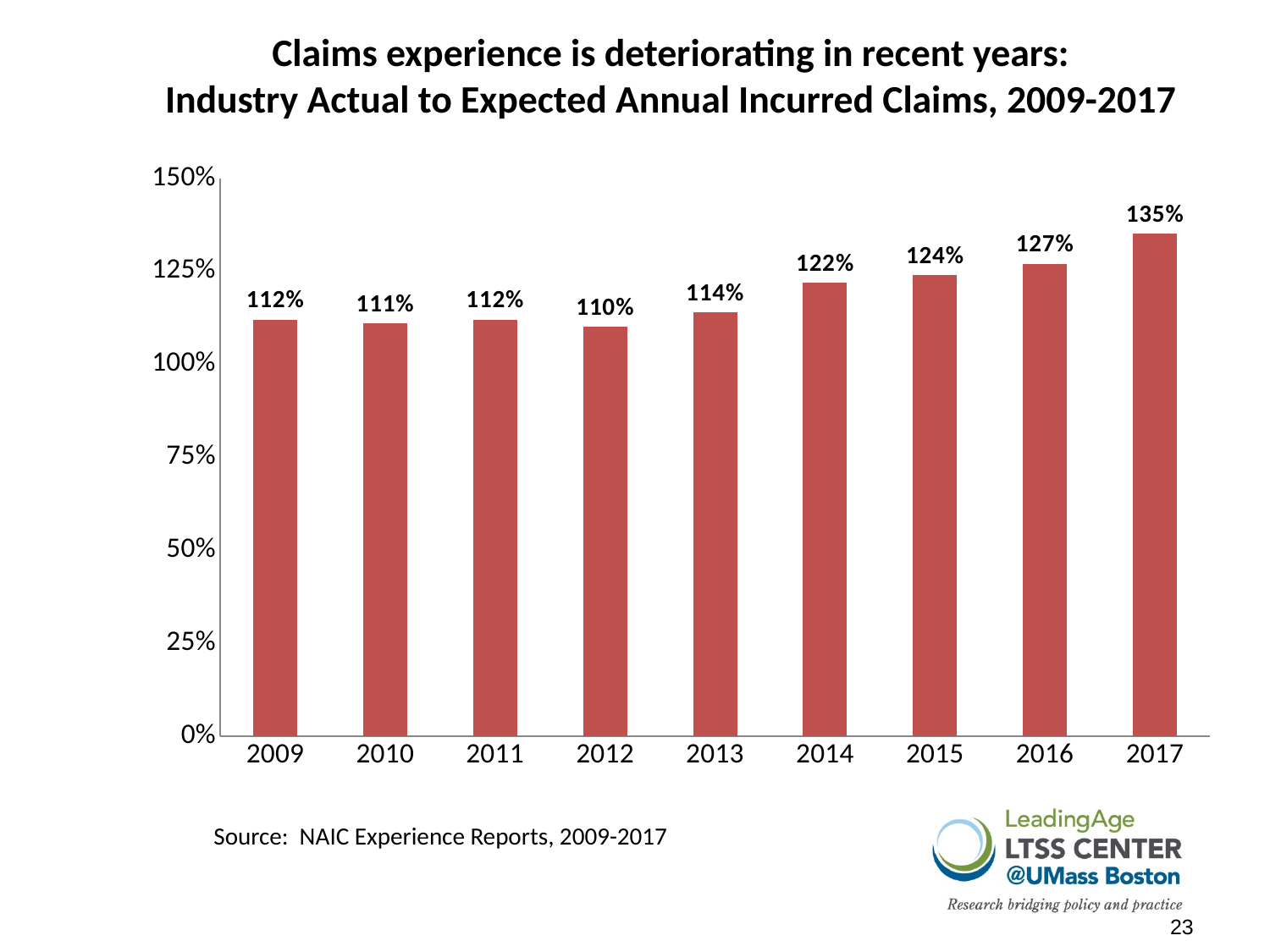
Is the value for 2016 greater or less than 125%? greater Which year has the lowest actual to expected claims ratio? 2012 What is the value shown for 2012? 110% Which year has the highest actual to expected claims ratio? 2017 How many years are shown on the x axis? 9 What is the actual to expected annual incurred claims value for 2017? 135% What kind of chart is shown on the slide? Bar chart What is the value shown for 2014? 122% What is the difference between the 2017 value and the 2009 value? 23% Which year has a larger value, 2013 or 2015? 2015 Do the values generally rise or fall from 2012 to 2017? Rise What is the difference between the 2016 value and the 2015 value? 3%